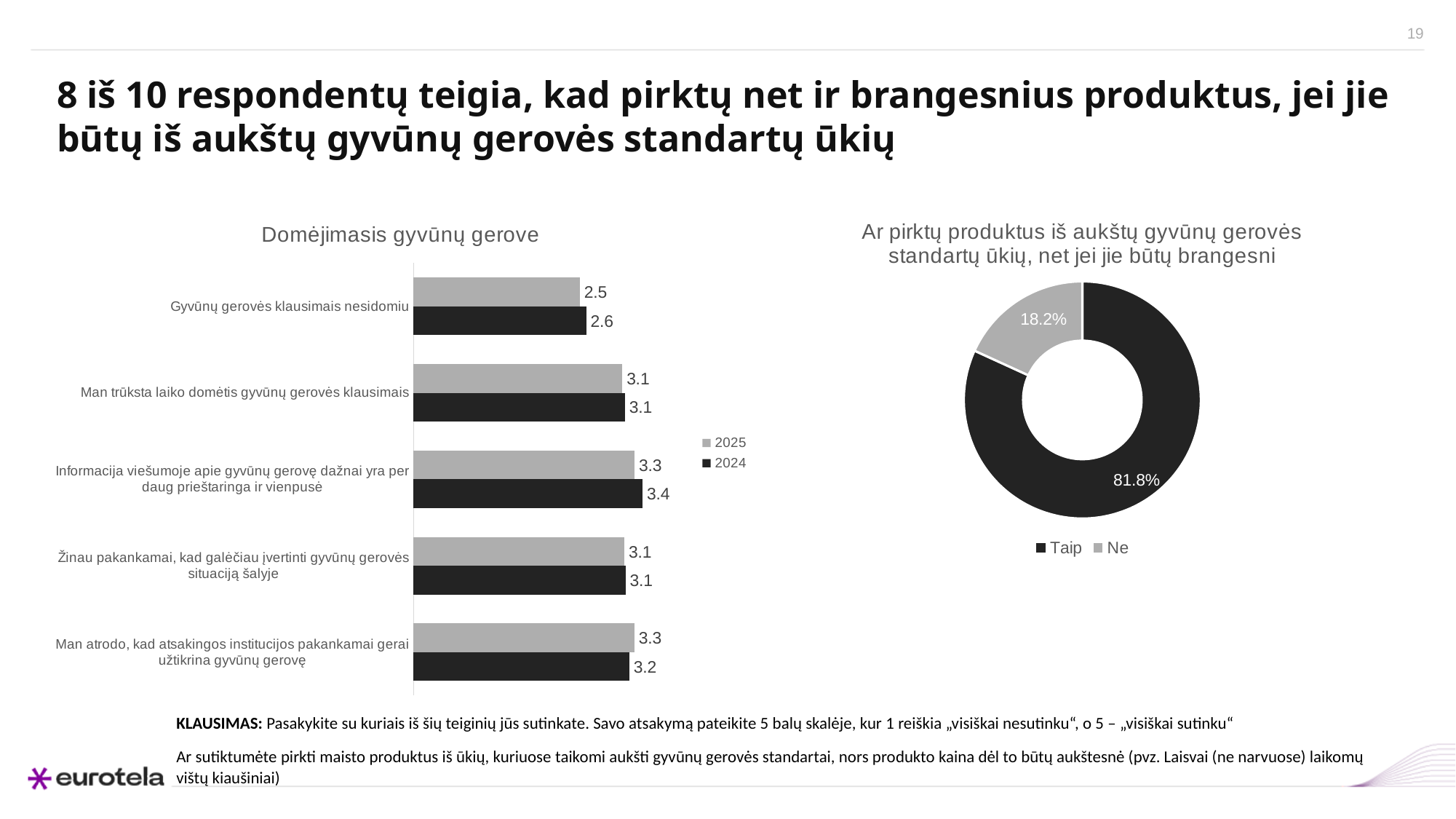
In the chart "Domėjimasis gyvūnų gerove", what is the difference between the 2024 and 2025 values for "Gyvūnų gerovės klausimais nesidomiu"? 0.1 In the chart "Ar pirktų produktus iš aukštų gyvūnų gerovės standartų ūkių, net jei jie būtų brangesni", what is the value for "Ne"? 18.2% How many statements (categories) are shown in the chart "Domėjimasis gyvūnų gerove"? 5 In the chart "Domėjimasis gyvūnų gerove", what is the 2024 value for "Man atrodo, kad atsakingos institucijos pakankamai gerai užtikrina gyvūnų gerovę"? 3.2 In the chart "Ar pirktų produktus iš aukštų gyvūnų gerovės standartų ūkių, net jei jie būtų brangesni", what share of respondents answered "Taip"? 81.8% How many series does the legend of the chart "Domėjimasis gyvūnų gerove" list? 2 In the chart "Domėjimasis gyvūnų gerove", which statement has the lowest 2025 value? Gyvūnų gerovės klausimais nesidomiu What type of chart is "Domėjimasis gyvūnų gerove"? Bar chart In the chart "Domėjimasis gyvūnų gerove", what is the 2025 value for "Gyvūnų gerovės klausimais nesidomiu"? 2.5 In the chart "Domėjimasis gyvūnų gerove", what is the 2024 value for "Informacija viešumoje apie gyvūnų gerovę dažnai yra per daug prieštaringa ir vienpusė"? 3.4 In the chart "Domėjimasis gyvūnų gerove", which statement has the highest 2024 value? Informacija viešumoje apie gyvūnų gerovę dažnai yra per daug prieštaringa ir vienpusė In the chart "Domėjimasis gyvūnų gerove", for "Man atrodo, kad atsakingos institucijos pakankamai gerai užtikrina gyvūnų gerovę", which year has the larger value, 2025 or 2024? 2025